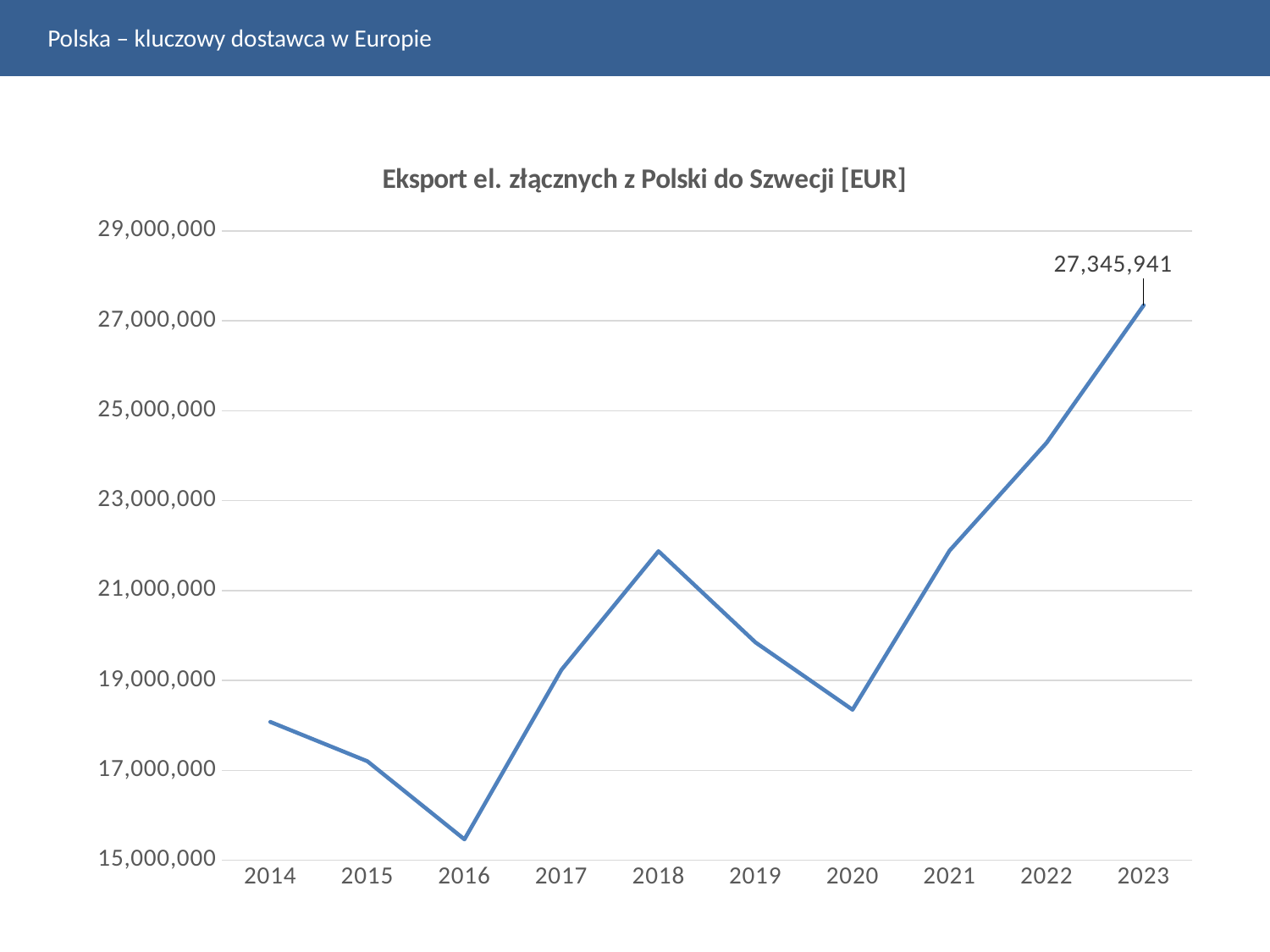
What is the value for 2023? 27,345,941 Is the value for 2018 greater or less than 21,000,000? greater How many years are plotted on the chart? 10 Do the values rise or fall from 2020 to 2023? rise Which is larger, the value for 2014 or the value for 2016? 2014 Is the value for 2016 greater or less than 17,000,000? less Which is larger, the value for 2018 or the value for 2019? 2018 Which year has the lowest value? 2016 Which year has the highest value? 2023 What kind of chart is shown? line chart Is the value for 2020 greater or less than 19,000,000? less